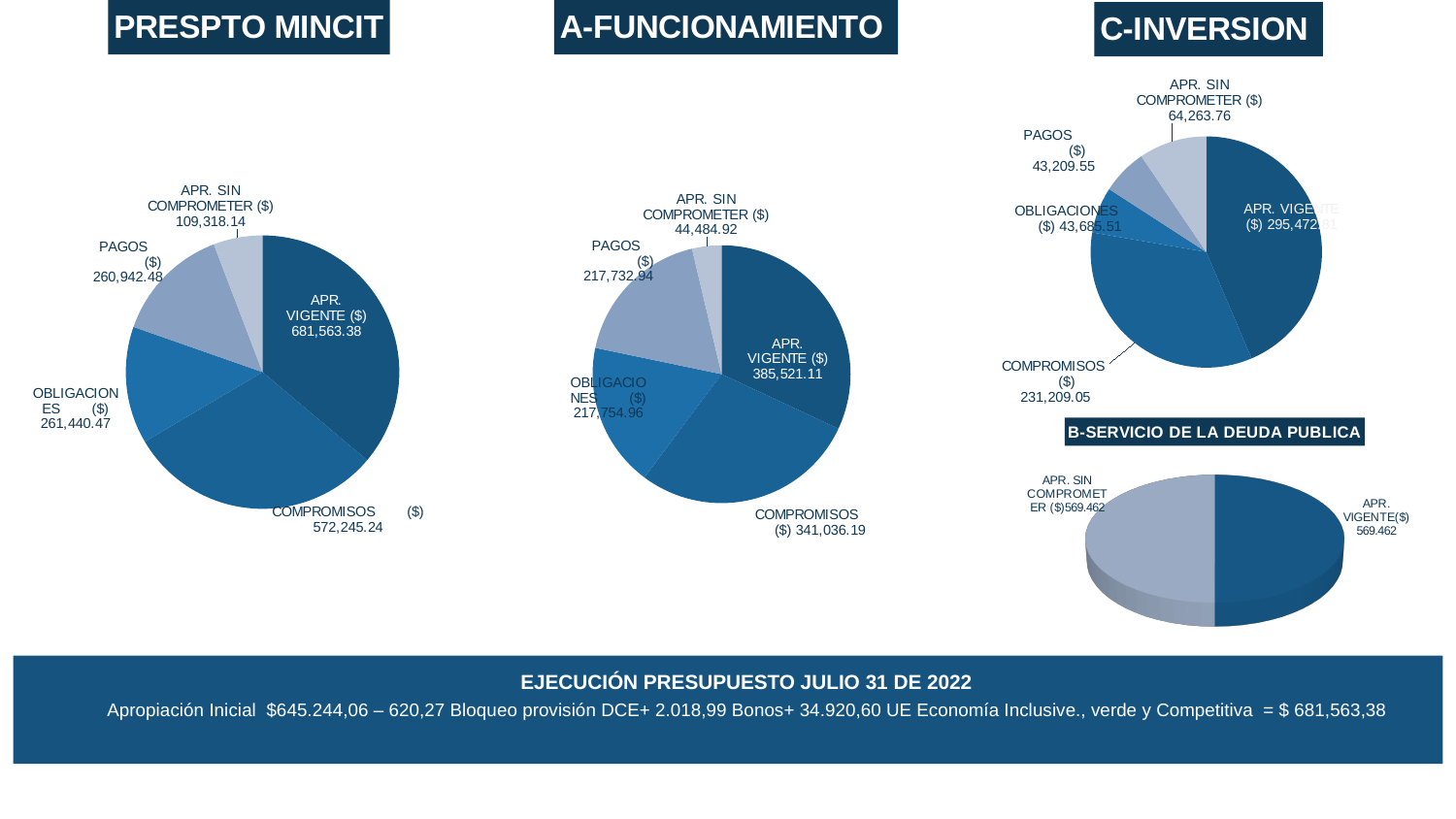
In the A-FUNCIONAMIENTO chart, what is the value for PAGOS ($)? 217,732.94 In the A-FUNCIONAMIENTO chart, which is larger, COMPROMISOS ($) or APR. SIN COMPROMETER ($)? COMPROMISOS ($) In the C-INVERSION chart, what is the value for APR. SIN COMPROMETER ($)? 64,263.76 In the PRESPTO MINCIT chart, what is the value for COMPROMISOS ($)? 572,245.24 What kind of chart is the PRESPTO MINCIT chart? Pie chart In the PRESPTO MINCIT chart, what is the difference between APR. VIGENTE ($) and COMPROMISOS ($)? 109,318.14 In the C-INVERSION chart, what is the value for COMPROMISOS ($)? 231,209.05 In the PRESPTO MINCIT chart, which category has the smallest slice? APR. SIN COMPROMETER ($) In the PRESPTO MINCIT chart, what is the value for APR. VIGENTE ($)? 681,563.38 In the A-FUNCIONAMIENTO chart, what is the value for APR. SIN COMPROMETER ($)? 44,484.92 In the A-FUNCIONAMIENTO chart, which category has the largest slice? APR. VIGENTE ($) How many slices does the B-SERVICIO DE LA DEUDA PUBLICA chart have? 2